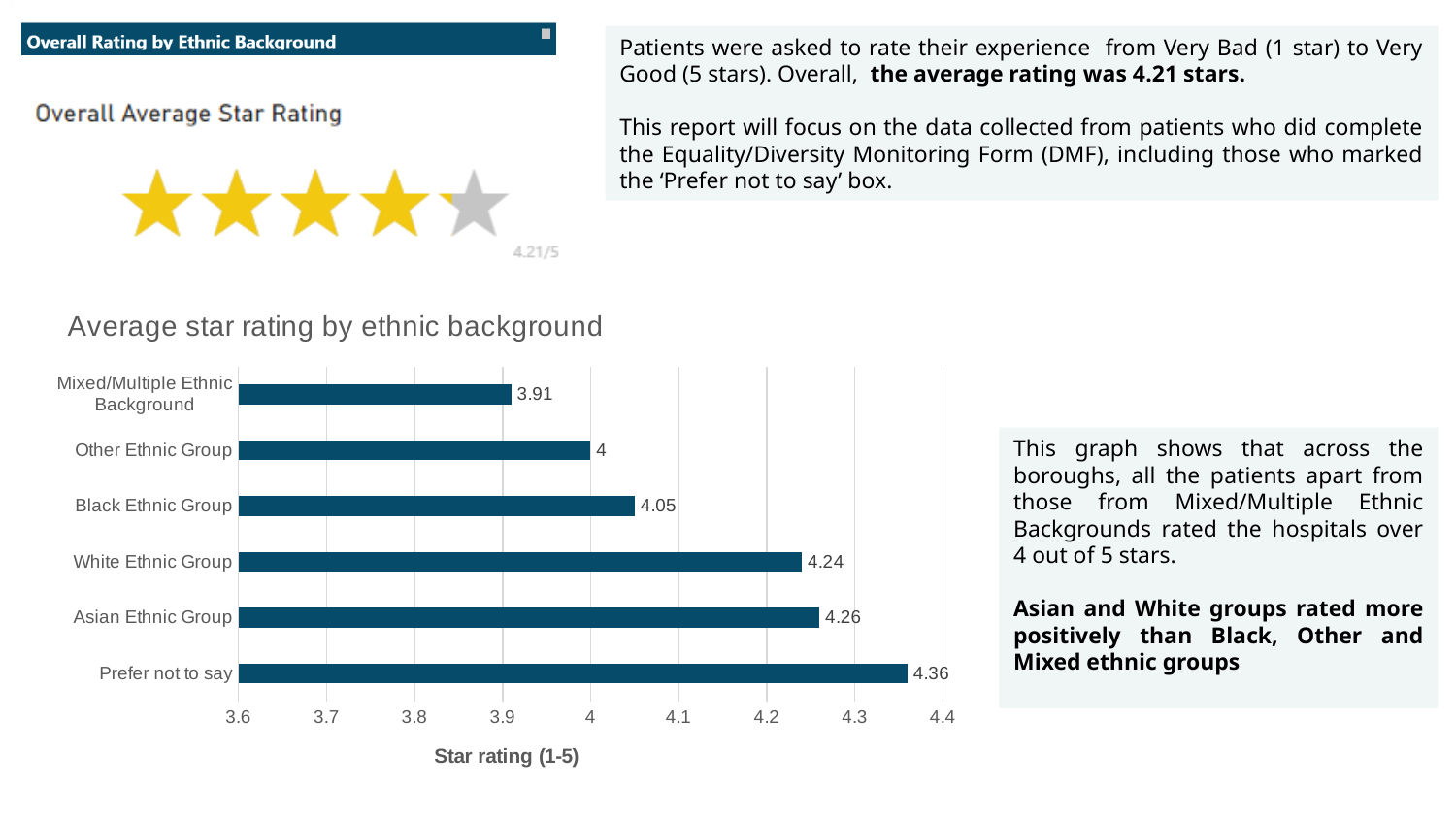
What is the title of the chart? Average star rating by ethnic background How many ethnic background categories are shown in the chart? 6 Which has a higher average star rating, the Black Ethnic Group or the Other Ethnic Group? Black Ethnic Group What is the label on the horizontal axis of the chart? Star rating (1-5) What is the difference between the average star rating for Prefer not to say and for the White Ethnic Group? 0.12 Which category has the highest average star rating? Prefer not to say Which category has the lowest average star rating? Mixed/Multiple Ethnic Background What is the average star rating for the Black Ethnic Group? 4.05 What is the average star rating for the Mixed/Multiple Ethnic Background group? 3.91 What is the average star rating for the Asian Ethnic Group? 4.26 What type of chart is used to show average star rating by ethnic background? Bar chart Is the average star rating for the White Ethnic Group greater or less than 4.2? greater